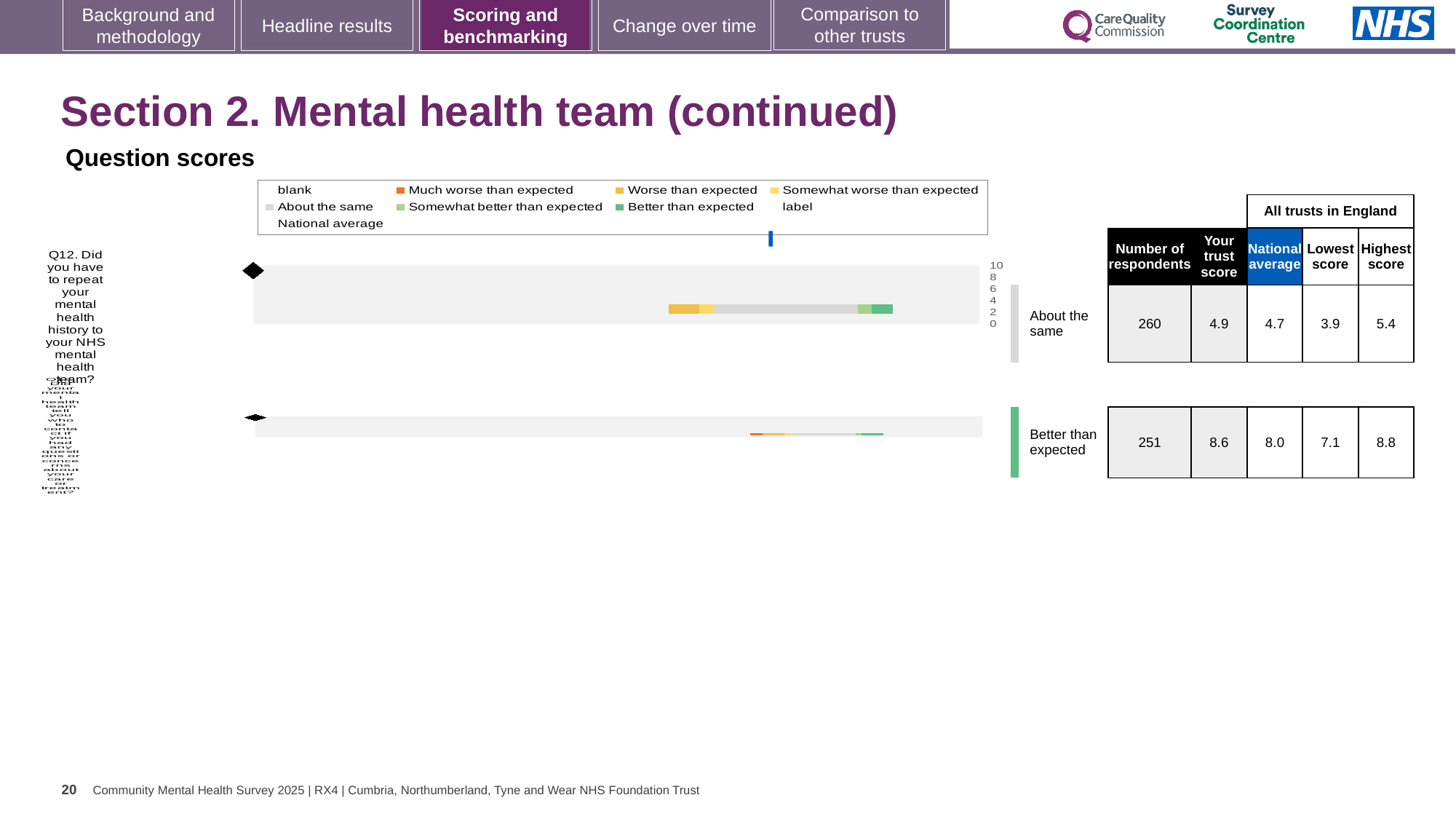
What is the 'Your trust score' value for Q12 (repeating mental health history)? 4.9 How many question rows are plotted in the question scores chart? 2 What is the highest score among all trusts in England for Q12? 5.4 How many respondents answered Q12? 260 What kind of chart is used to show the question scores on this slide? bar chart What is the difference between the highest and lowest trust scores in England for Q12? 1.5 What benchmark rating is shown for Q12? About the same For the question rated 'Better than expected', what is the trust score? 8.6 For the question rated 'Better than expected', what is the difference between the trust score and the national average? 0.6 What is the lowest score among all trusts in England for Q12? 3.9 What is the national average score for Q12? 4.7 For Q12, is the trust score higher or lower than the national average? higher